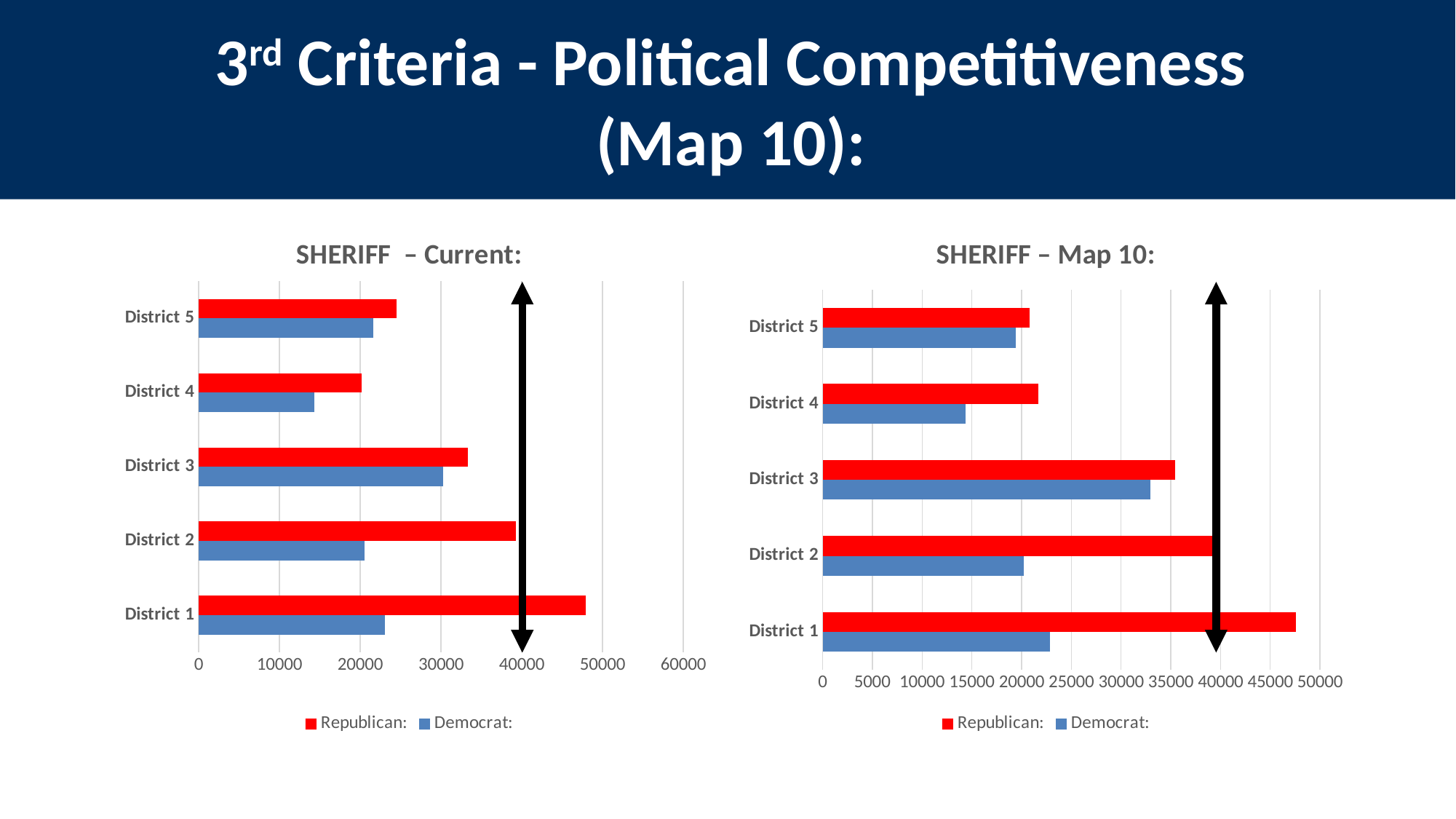
How many districts are shown on the "SHERIFF – Map 10:" chart? 5 Which colour represents the Democrat series on the "SHERIFF – Map 10:" chart? blue On the "SHERIFF – Map 10:" chart, which district has the highest Republican value? District 1 How many series does the legend of the "SHERIFF – Current:" chart list? 2 On the "SHERIFF – Current:" chart, is the Republican value for District 1 greater or less than 40000? greater On the "SHERIFF – Map 10:" chart, is the Democrat value for District 3 greater or less than 30000? greater On the "SHERIFF – Current:" chart, which district has the highest Republican value? District 1 On the "SHERIFF – Current:" chart, is the Democrat value for District 4 greater or less than 20000? less On the "SHERIFF – Map 10:" chart, which district has the lowest Democrat value? District 4 On the "SHERIFF – Current:" chart, which is larger for District 2, the Republican value or the Democrat value? Republican On the "SHERIFF – Current:" chart, which district has the lowest Democrat value? District 4 What kind of chart is the "SHERIFF – Current:" chart? bar chart